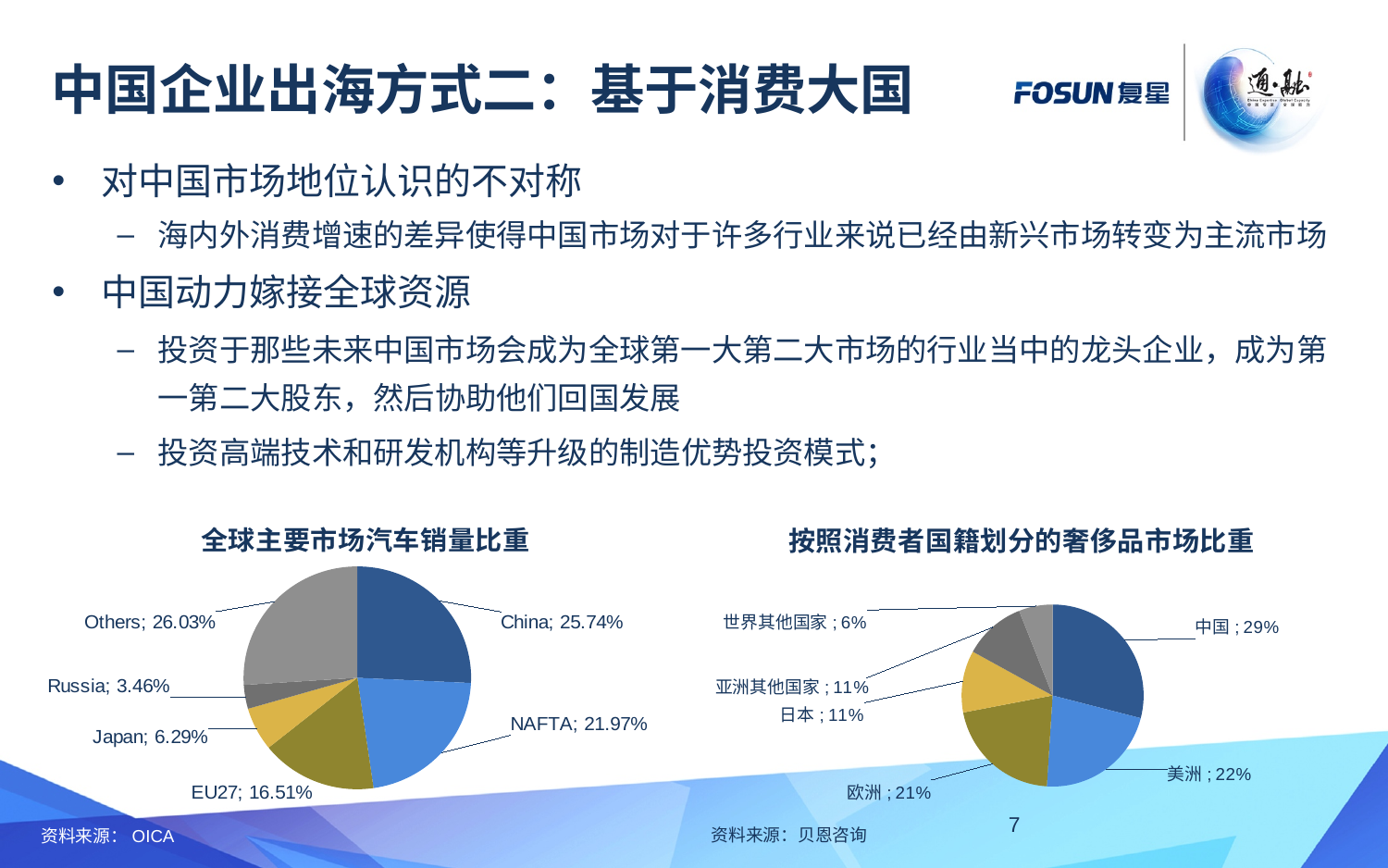
In the chart titled 按照消费者国籍划分的奢侈品市场比重, which is larger, the value for 欧洲 or the value for 日本? 欧洲 In the chart titled 按照消费者国籍划分的奢侈品市场比重, what is the value for 美洲? 22% In the chart titled 按照消费者国籍划分的奢侈品市场比重, what is the difference between the values for 中国 and 欧洲? 8% In the chart titled 全球主要市场汽车销量比重, what is the difference between the values for NAFTA and Japan? 15.68% In the chart titled 全球主要市场汽车销量比重, what is the value for EU27? 16.51% In the chart titled 全球主要市场汽车销量比重, how many categories are shown? 6 In the chart titled 全球主要市场汽车销量比重, what is the value for China? 25.74% In the chart titled 全球主要市场汽车销量比重, which category has the smallest share? Russia In the chart titled 按照消费者国籍划分的奢侈品市场比重, which category has the largest share? 中国 In the chart titled 按照消费者国籍划分的奢侈品市场比重, how many categories are shown? 6 In the chart titled 按照消费者国籍划分的奢侈品市场比重, which category has the smallest share? 世界其他国家 In the chart titled 全球主要市场汽车销量比重, what kind of chart is it? Pie chart